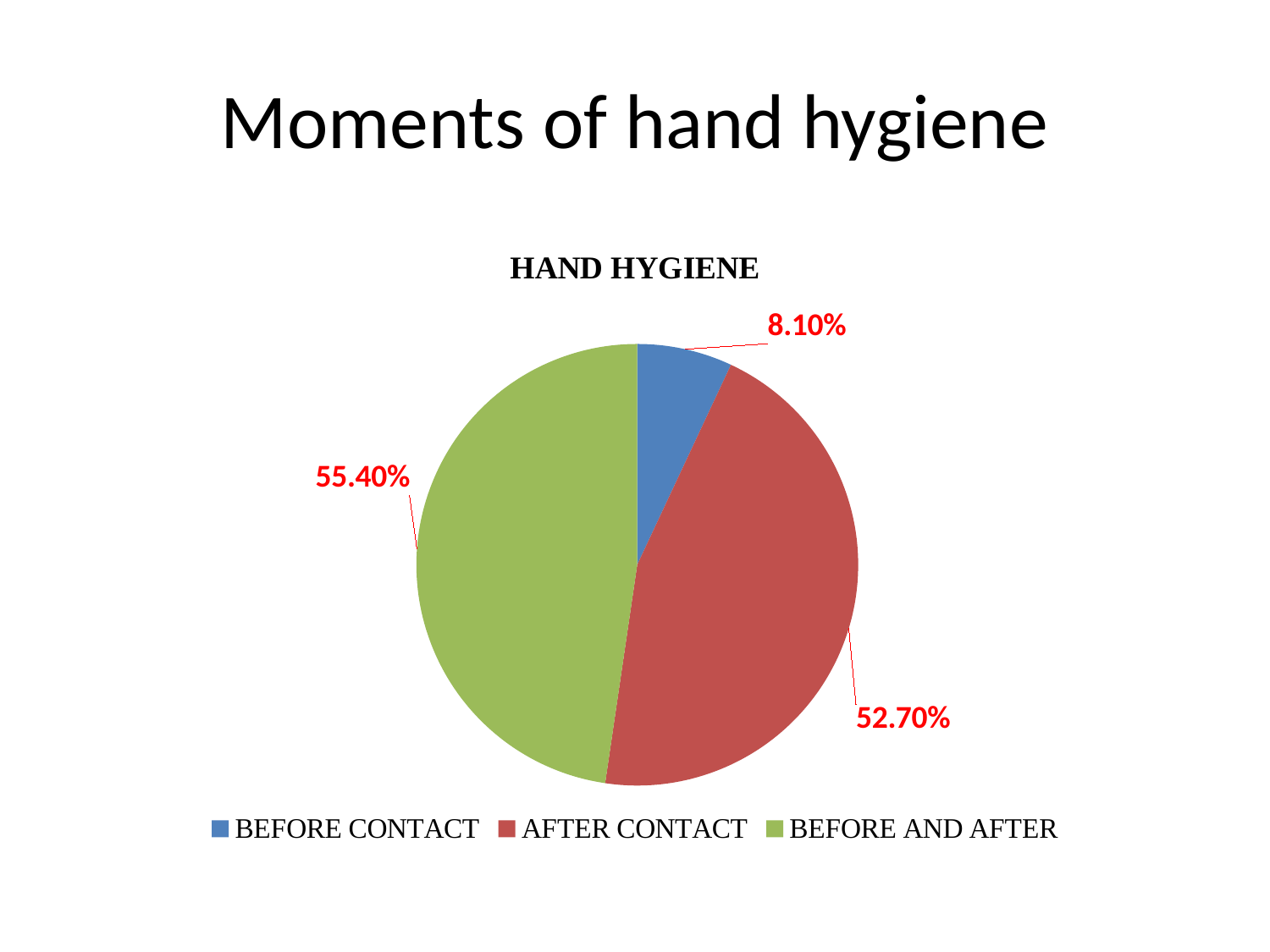
What type of chart is shown on the slide? Pie chart Which category has the largest slice of the pie? BEFORE AND AFTER How many entries does the legend list? 3 Which category has the smallest slice of the pie? BEFORE CONTACT Which colour represents AFTER CONTACT in the pie chart? Red What is the difference between the values for AFTER CONTACT and BEFORE CONTACT? 44.60% What is the title of the chart? HAND HYGIENE What value is shown for BEFORE AND AFTER? 55.40% How many slices does the pie chart have? 3 What value is shown for BEFORE CONTACT? 8.10% What value is shown for AFTER CONTACT? 52.70% What is the difference between the values for BEFORE AND AFTER and AFTER CONTACT? 2.70%